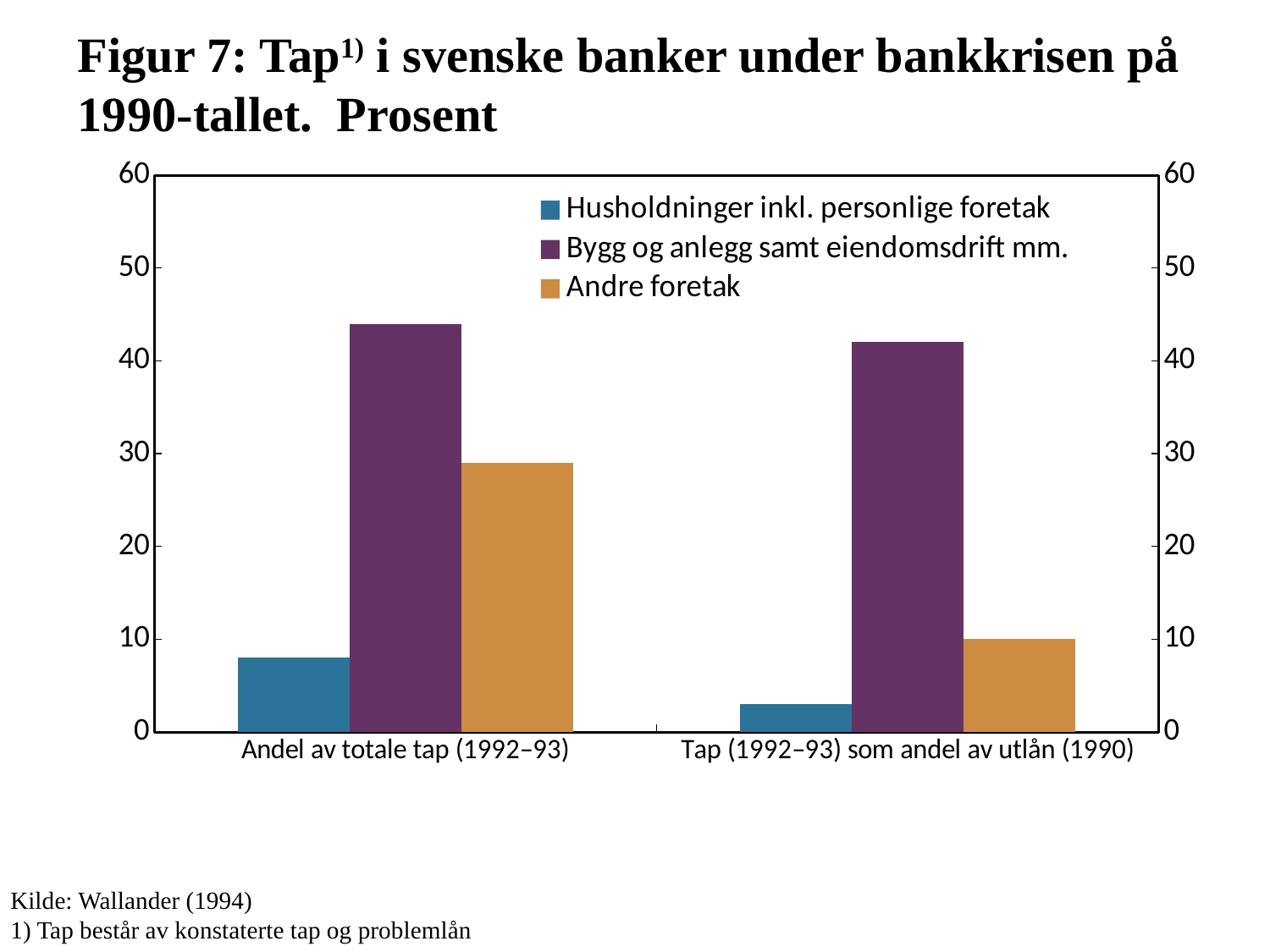
What is the source cited below the chart? Wallander (1994) Which series has the highest value in the category 'Andel av totale tap (1992–93)'? Bygg og anlegg samt eiendomsdrift mm. Is the value for 'Andre foretak' in 'Andel av totale tap (1992–93)' greater or less than 20? greater What kind of chart is shown on the slide? bar chart How many categories are shown on the x axis? 2 Which is larger: 'Andre foretak' in 'Andel av totale tap (1992–93)' or 'Andre foretak' in 'Tap (1992–93) som andel av utlån (1990)'? Andel av totale tap (1992–93) Is the value for 'Husholdninger inkl. personlige foretak' in 'Tap (1992–93) som andel av utlån (1990)' greater or less than 10? less Which series has the lowest value in the category 'Tap (1992–93) som andel av utlån (1990)'? Husholdninger inkl. personlige foretak Which colour represents 'Andre foretak' in the legend? orange How many series does the legend list? 3 Is the value for 'Bygg og anlegg samt eiendomsdrift mm.' in 'Andel av totale tap (1992–93)' greater or less than 40? greater